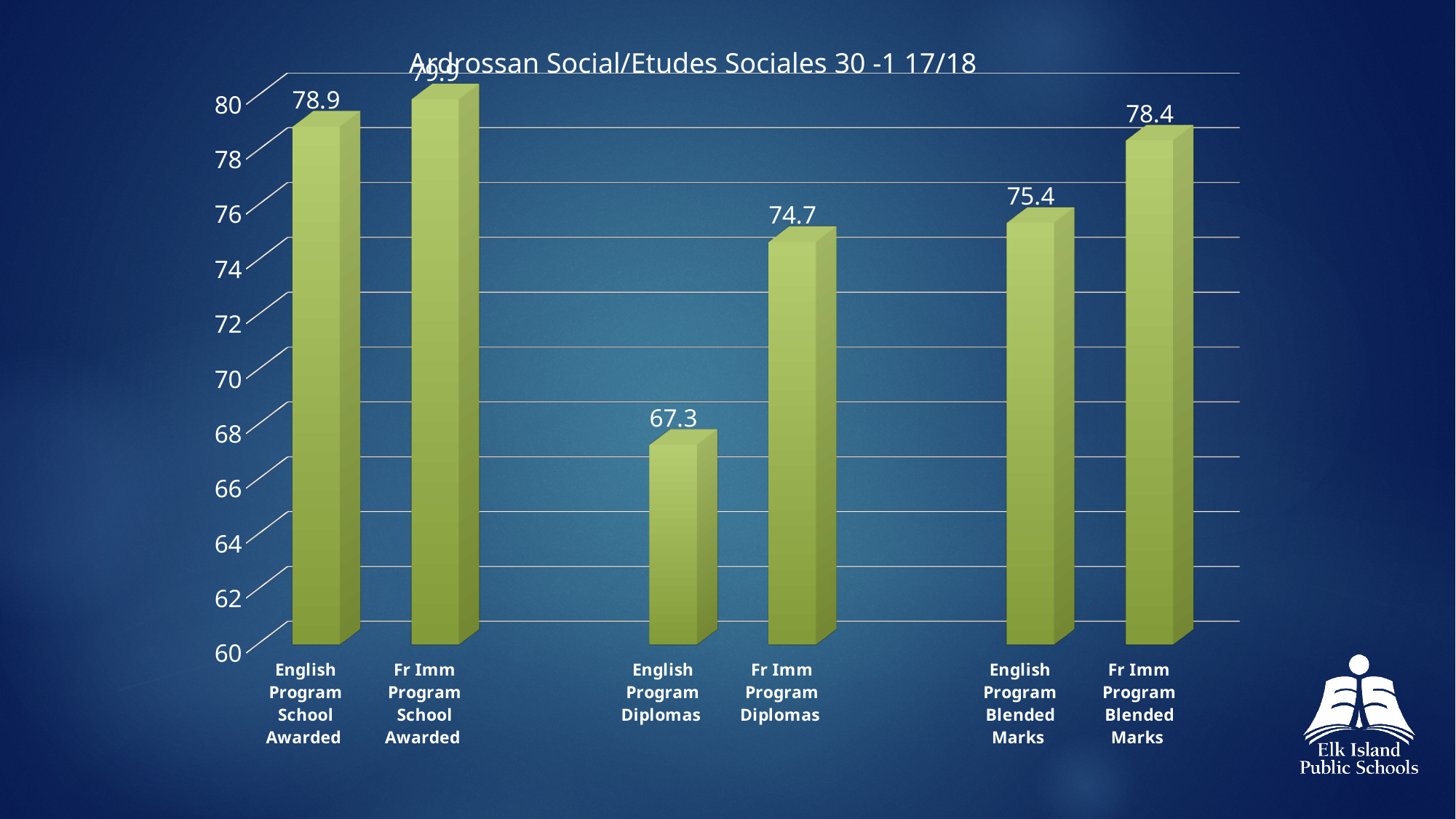
What is the difference between Fr Imm Program Diplomas and English Program Diplomas? 7.4 How many bars are shown in the chart? 6 Which category has the highest value? Fr Imm Program School Awarded What is the title of the chart? Ardrossan Social/Etudes Sociales 30 -1 17/18 Which is larger, English Program Blended Marks or Fr Imm Program Blended Marks? Fr Imm Program Blended Marks What is the value for English Program Diplomas? 67.3 Which category has the lowest value? English Program Diplomas What is the value for Fr Imm Program Blended Marks? 78.4 What is the value for English Program Blended Marks? 75.4 What kind of chart is this? Bar chart What is the value for English Program School Awarded? 78.9 What is the value for Fr Imm Program Diplomas? 74.7